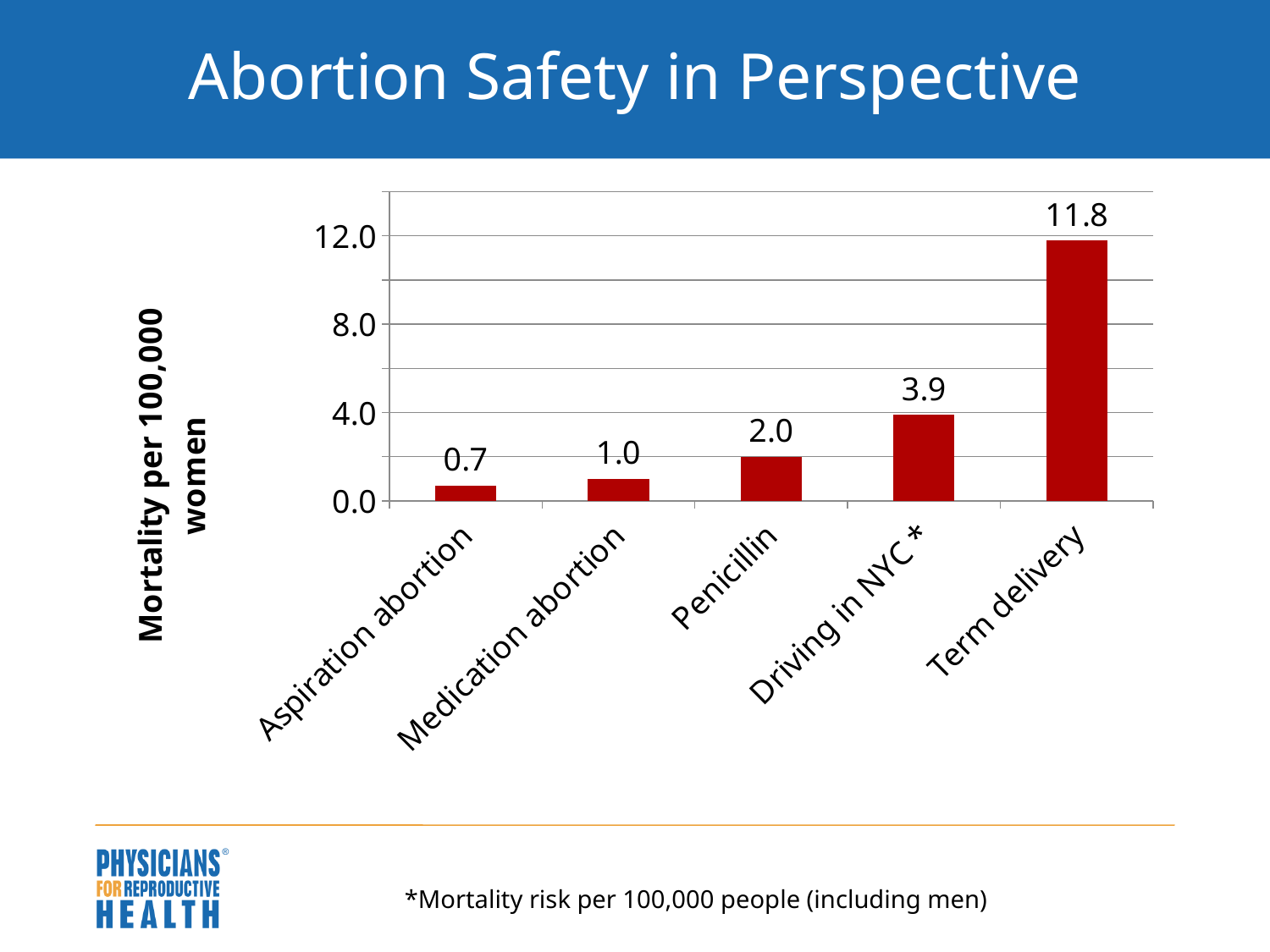
Which is larger, the value for Penicillin or the value for Medication abortion? Penicillin What is the mortality per 100,000 women for Medication abortion? 1.0 What is the value shown for Term delivery? 11.8 What is the label on the vertical axis of the chart? Mortality per 100,000 women What is the value shown for Driving in NYC *? 3.9 What kind of chart is shown on the slide? Bar chart Which category has the lowest mortality per 100,000 women? Aspiration abortion Which category has the highest mortality per 100,000 women? Term delivery How many categories are shown on the x axis? 5 What is the value shown for Penicillin? 2.0 What is the difference between the values for Term delivery and Driving in NYC *? 7.9 What is the mortality per 100,000 women for Aspiration abortion? 0.7